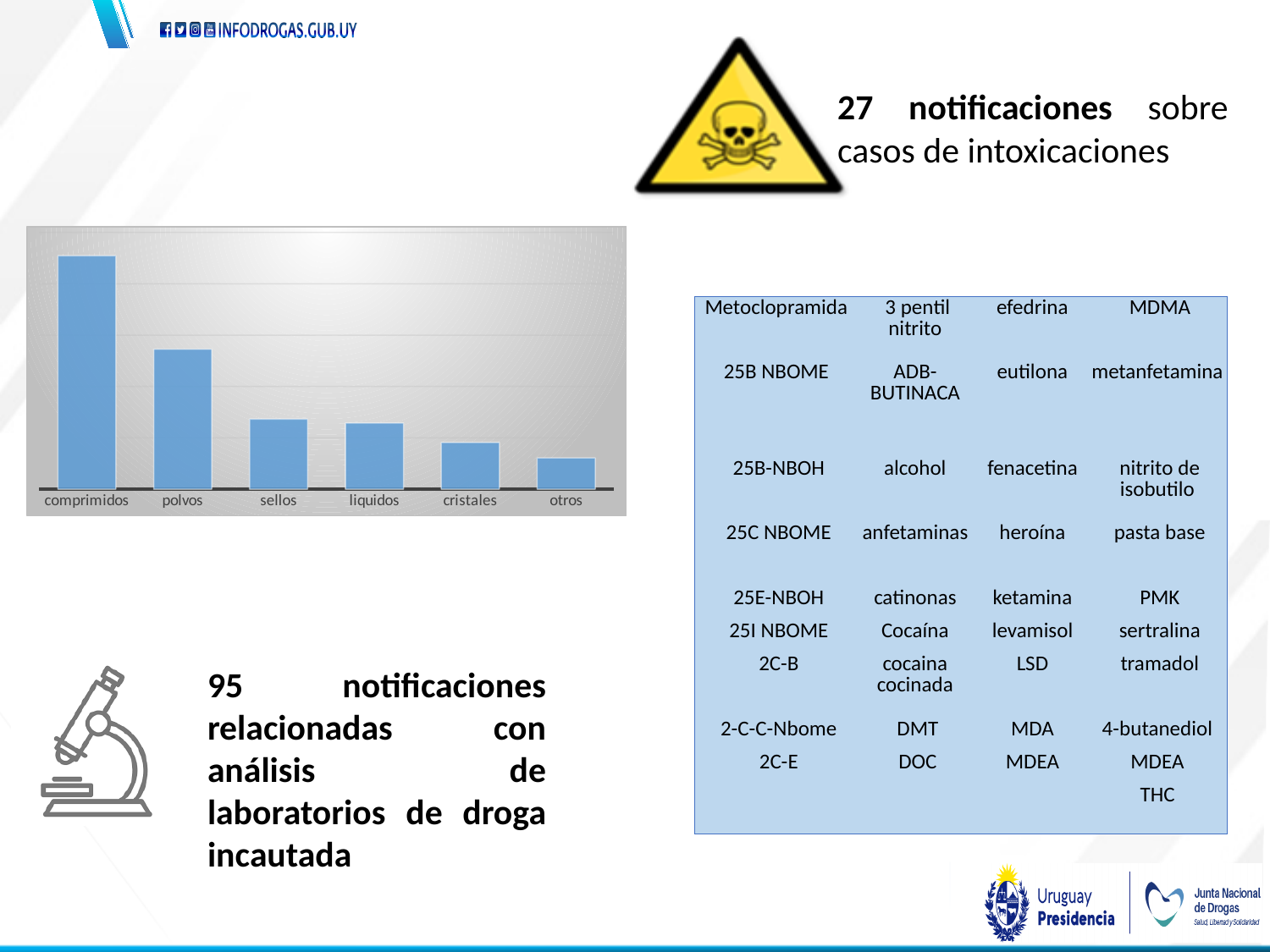
What kind of chart is shown on the left of the slide? bar chart In the bar chart, which is larger, comprimidos or polvos? comprimidos Which category has the tallest bar in the bar chart? comprimidos How many categories are shown on the x axis of the bar chart? 6 In the bar chart, which is larger, liquidos or cristales? liquidos Do the bar values rise or fall from left to right along the x axis of the bar chart? fall What is the second category from the left on the x axis of the bar chart? polvos Which category has the shortest bar in the bar chart? otros In the bar chart, which is larger, polvos or sellos? polvos What colour are the bars in the bar chart? blue